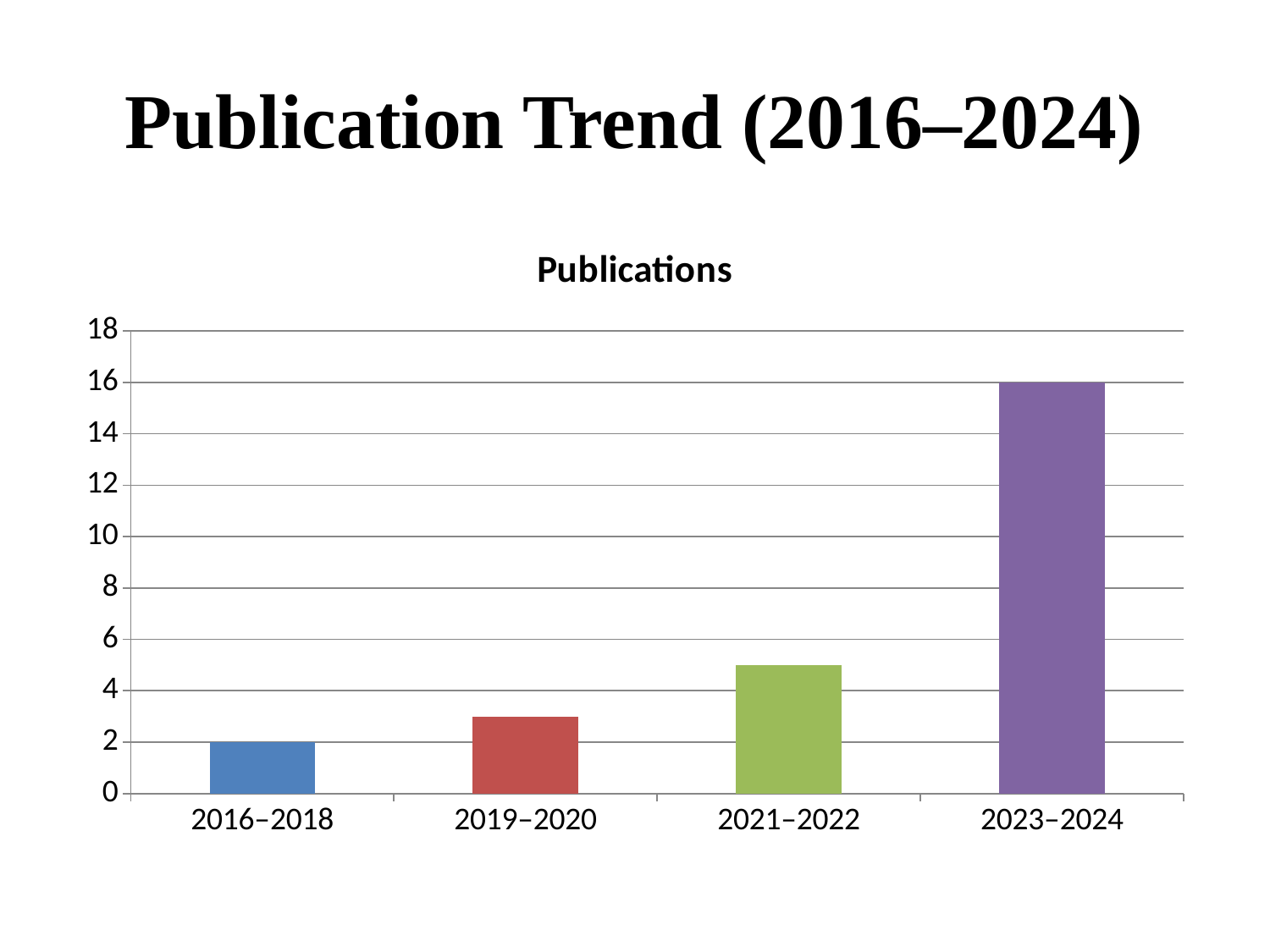
Do the values rise or fall from 2016–2018 to 2023–2024? rise Is the value for 2019–2020 greater or less than 4? less What is the value for 2016–2018? 2 Which is larger, the value for 2021–2022 or the value for 2019–2020? 2021–2022 What is the value for 2023–2024? 16 What is the difference between the values for 2023–2024 and 2016–2018? 14 Which period has the highest number of publications? 2023–2024 Is the value for 2021–2022 greater or less than 4? greater What kind of chart is shown? bar chart Is the value for 2021–2022 greater or less than 6? less Which period has the lowest number of publications? 2016–2018 How many periods are shown on the x axis? 4